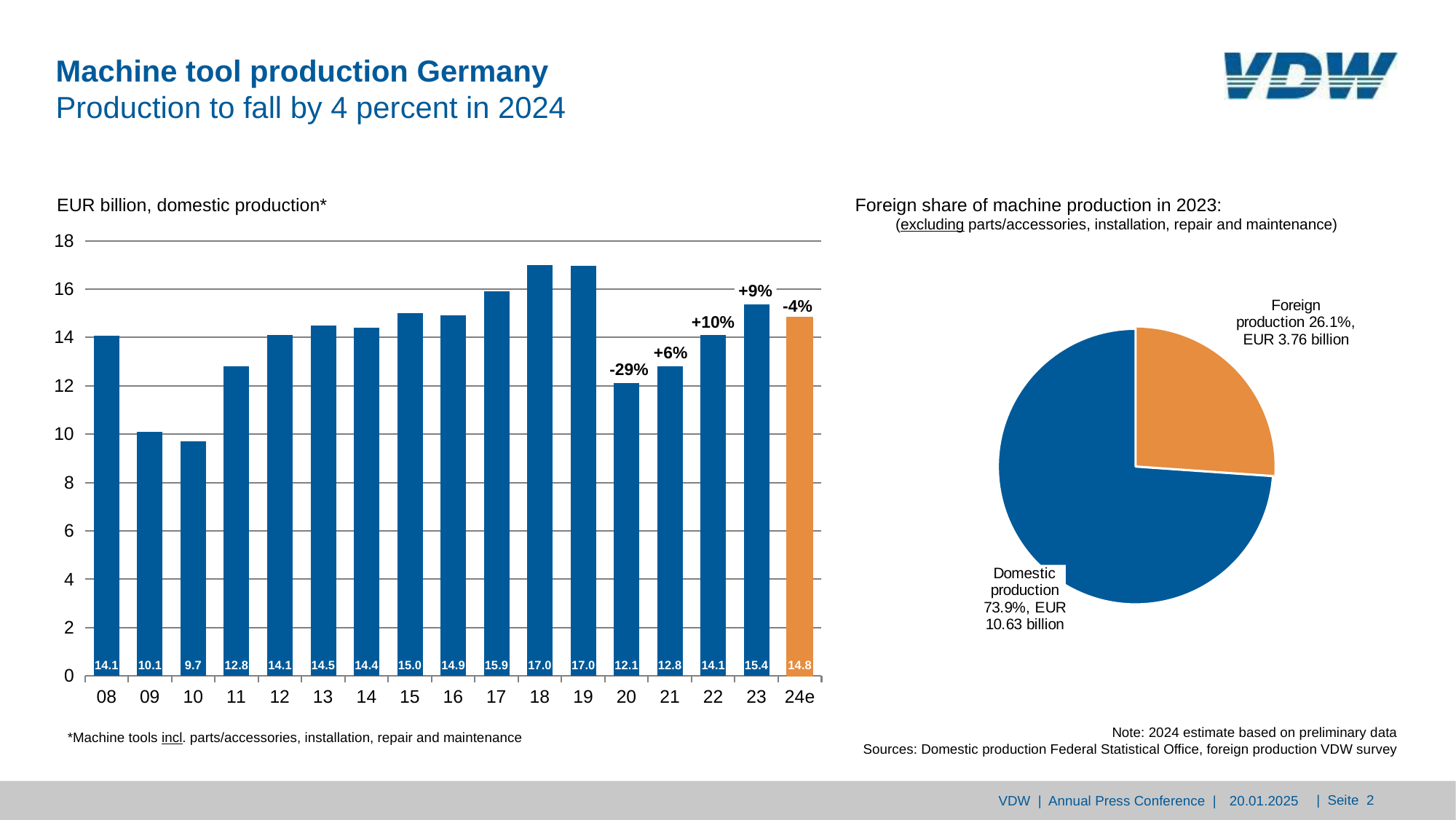
In the bar chart on the left, which is larger, the value for 2013 or the value for 2014? 2013 In the bar chart on the left, how many years (bars) are shown? 17 In the bar chart on the left, what is the domestic production value for 2010? 9.7 In the bar chart on the left, which bar is coloured orange instead of blue? 24e In the bar chart on the left, do the values rise or fall from 2020 to 2023? rise What kind of chart is shown on the left of the slide? bar chart In the bar chart on the left, what percentage change is labelled above the 2020 bar? -29% In the pie chart on the right, what share does foreign production have? 26.1% In the bar chart on the left, what is the domestic production value for 24e? 14.8 In the bar chart on the left, which year has the lowest domestic production value? 10 In the bar chart on the left, what is the difference between the 2023 value and the 2022 value? 1.3 In the pie chart on the right, what is the value of domestic production in EUR billion? EUR 10.63 billion